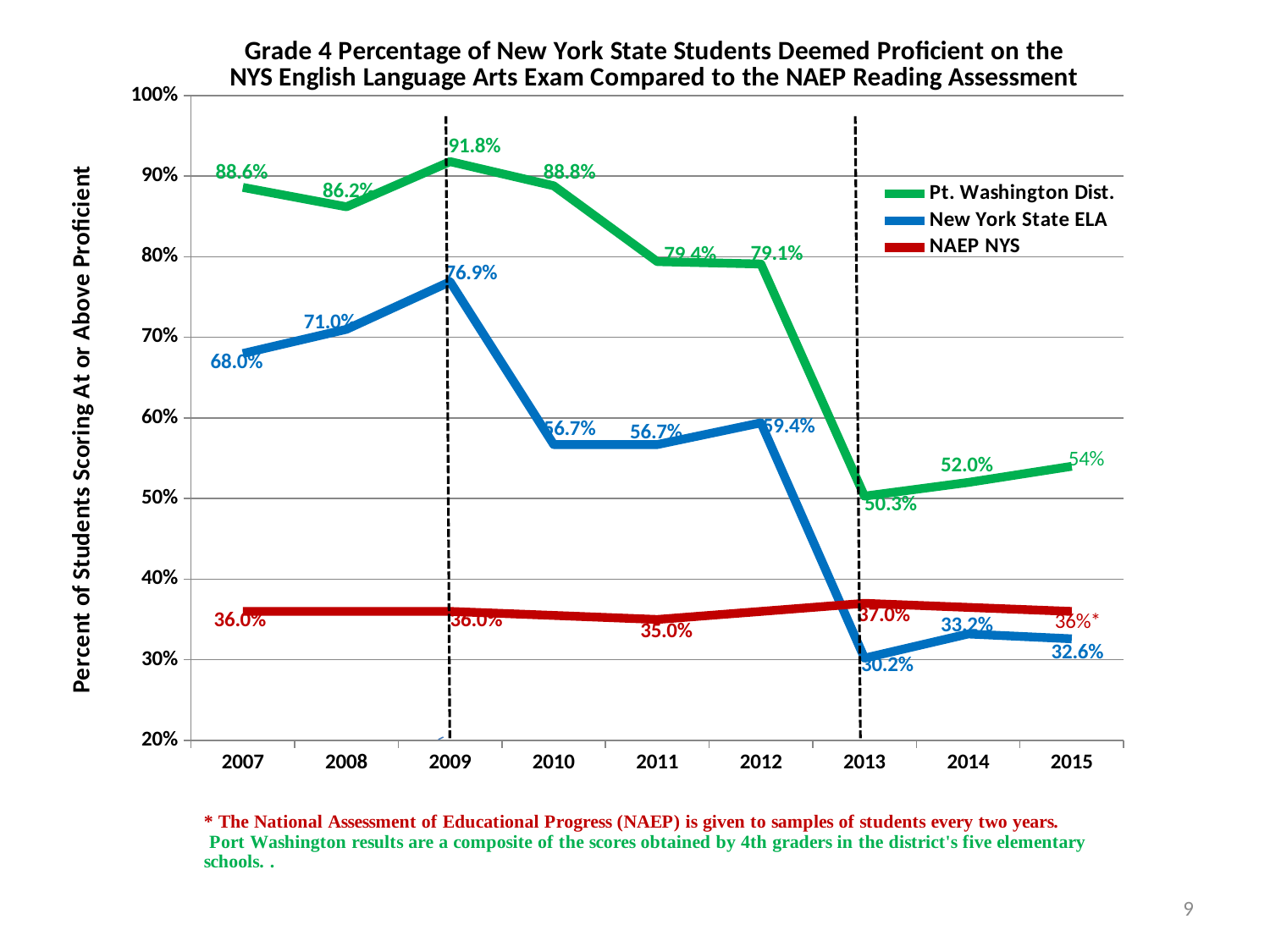
What is the value for Pt. Washington Dist. in 2009? 91.8% What is the value for New York State ELA in 2013? 30.2% Does the New York State ELA value rise or fall from 2009 to 2013? Fall Which is larger in 2015, the Pt. Washington Dist. value or the NAEP NYS value? Pt. Washington Dist. What is the difference between the Pt. Washington Dist. values in 2012 and 2013? 28.8 percentage points How many series does the legend list? 3 In which year is the New York State ELA value lowest? 2013 How many years are shown on the x axis? 9 What is the value for NAEP NYS in 2011? 35.0% What is the title of the y axis? Percent of Students Scoring At or Above Proficient In which year is the Pt. Washington Dist. value highest? 2009 What kind of chart is shown on the slide? Line chart